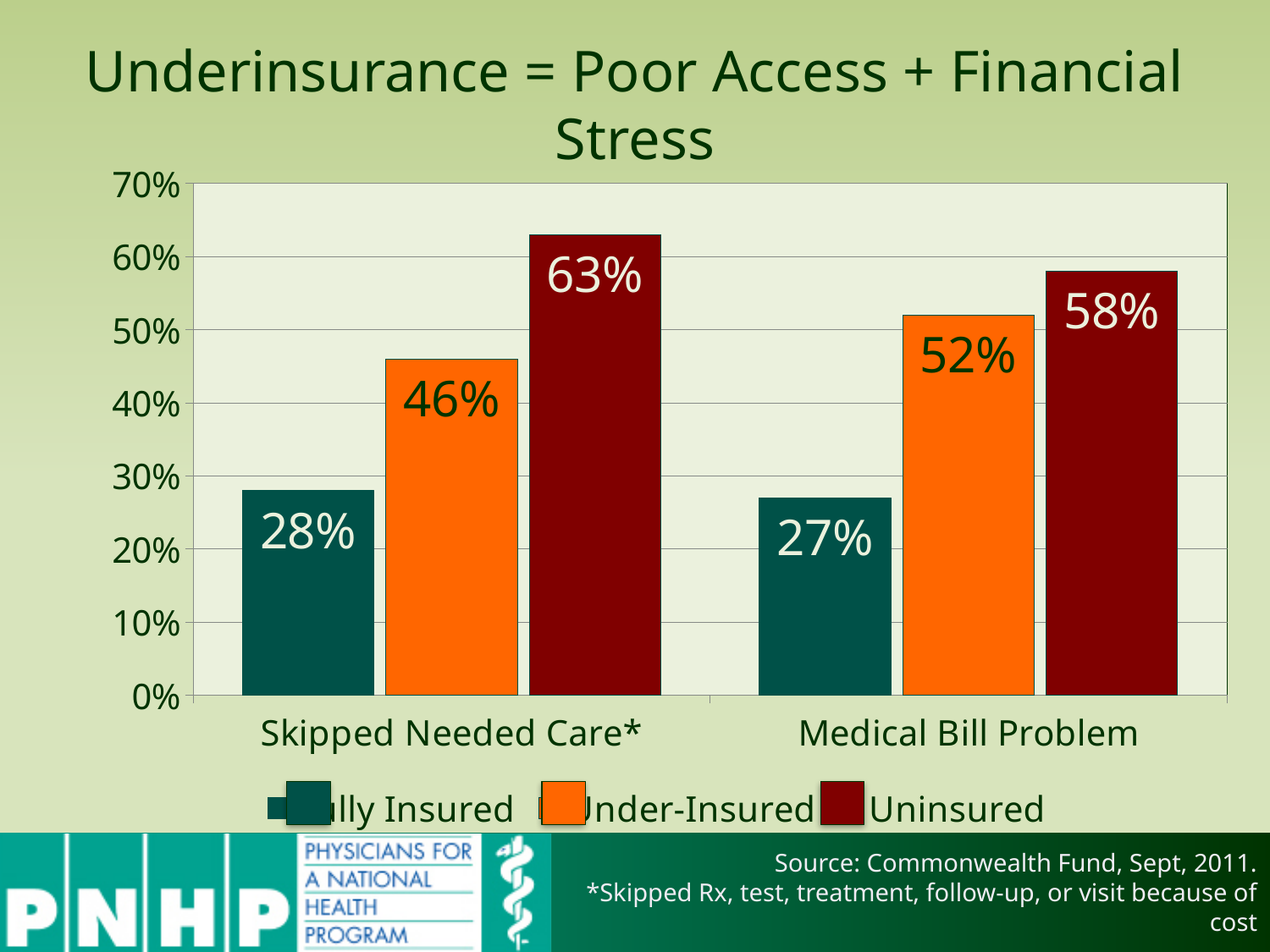
What kind of chart is shown on the slide? Bar chart How many categories are shown on the x axis? 2 What is the difference between the Uninsured values for Skipped Needed Care* and Medical Bill Problem? 5% What is the value for Under-Insured in the Skipped Needed Care* category? 46% What is the value for Under-Insured in the Medical Bill Problem category? 52% What is the lowest value shown in the Medical Bill Problem category? 27% What is the value for Uninsured in the Skipped Needed Care* category? 63% What is the value for Uninsured in the Medical Bill Problem category? 58% Which is larger: the Under-Insured value for Skipped Needed Care* or the Under-Insured value for Medical Bill Problem? Medical Bill Problem What is the difference between the Uninsured and Under-Insured values for Skipped Needed Care*? 17% How many series does the legend list? 3 Which series has the highest value in the Skipped Needed Care* category? Uninsured